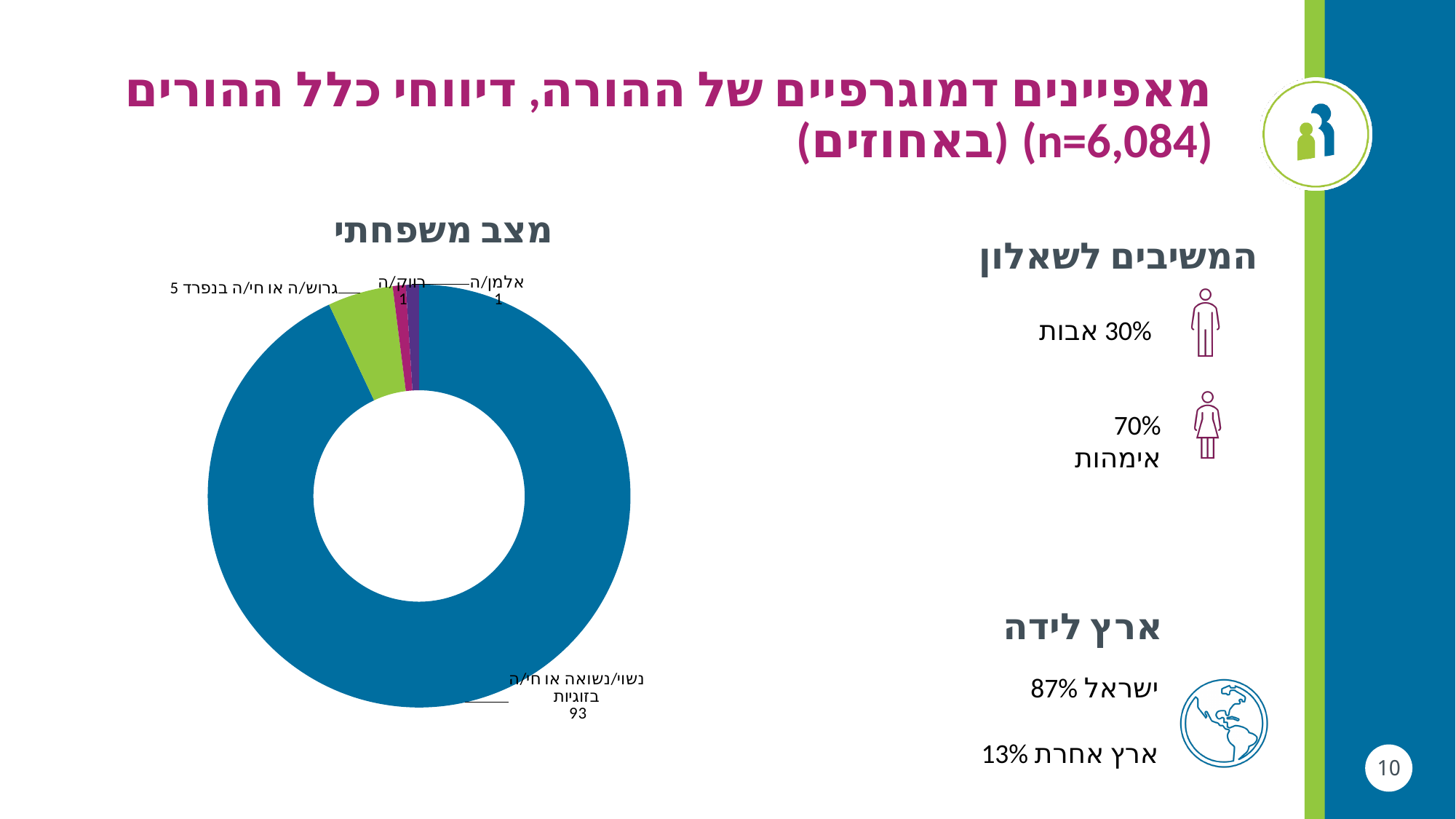
What is the value for 'אלמן/ה' in the 'מצב משפחתי' chart? 1 How many categories does the 'מצב משפחתי' chart show? 4 What is the value for 'רווק/ה' in the 'מצב משפחתי' chart? 1 What is the total of all the values shown in the 'מצב משפחתי' chart? 100 Which category has the largest slice in the 'מצב משפחתי' chart? נשוי/נשואה או חי/ה בזוגיות What is the title of the chart on the slide? מצב משפחתי Which is larger in the 'מצב משפחתי' chart: 'גרוש/ה או חי/ה בנפרד' or 'רווק/ה'? גרוש/ה או חי/ה בנפרד What kind of chart is the 'מצב משפחתי' chart? doughnut chart What colour is the largest slice in the 'מצב משפחתי' chart? blue What is the value for 'גרוש/ה או חי/ה בנפרד' in the 'מצב משפחתי' chart? 5 What is the difference between the values for 'נשוי/נשואה או חי/ה בזוגיות' and 'גרוש/ה או חי/ה בנפרד' in the 'מצב משפחתי' chart? 88 What is the value for 'נשוי/נשואה או חי/ה בזוגיות' in the 'מצב משפחתי' chart? 93